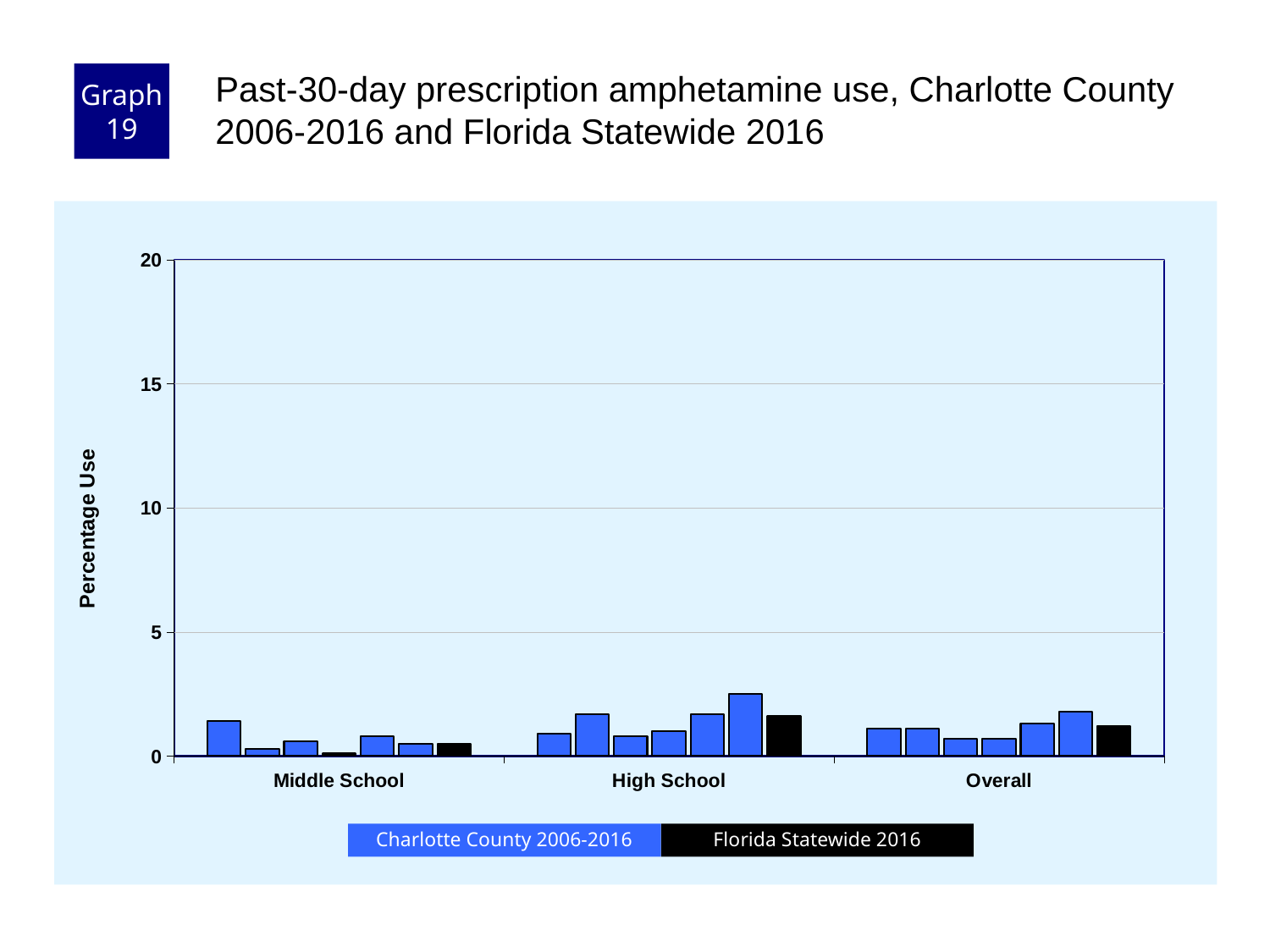
Which colour represents Florida Statewide 2016 in the legend? black Which is larger: the Florida Statewide 2016 value for High School or for Middle School? High School How many series does the legend list? 2 Which category group contains the tallest bar on the chart? High School Which category group has the lowest Florida Statewide 2016 value? Middle School Is the Florida Statewide 2016 value for Middle School greater or less than 5? less Which is larger: the Florida Statewide 2016 value for Overall or for Middle School? Overall How many categories are shown on the x axis? 3 Is the Florida Statewide 2016 value for High School greater or less than 5? less Is the tallest bar in the High School group greater or less than 5? less What is the label on the y axis? Percentage Use What kind of chart is shown on the slide? bar chart